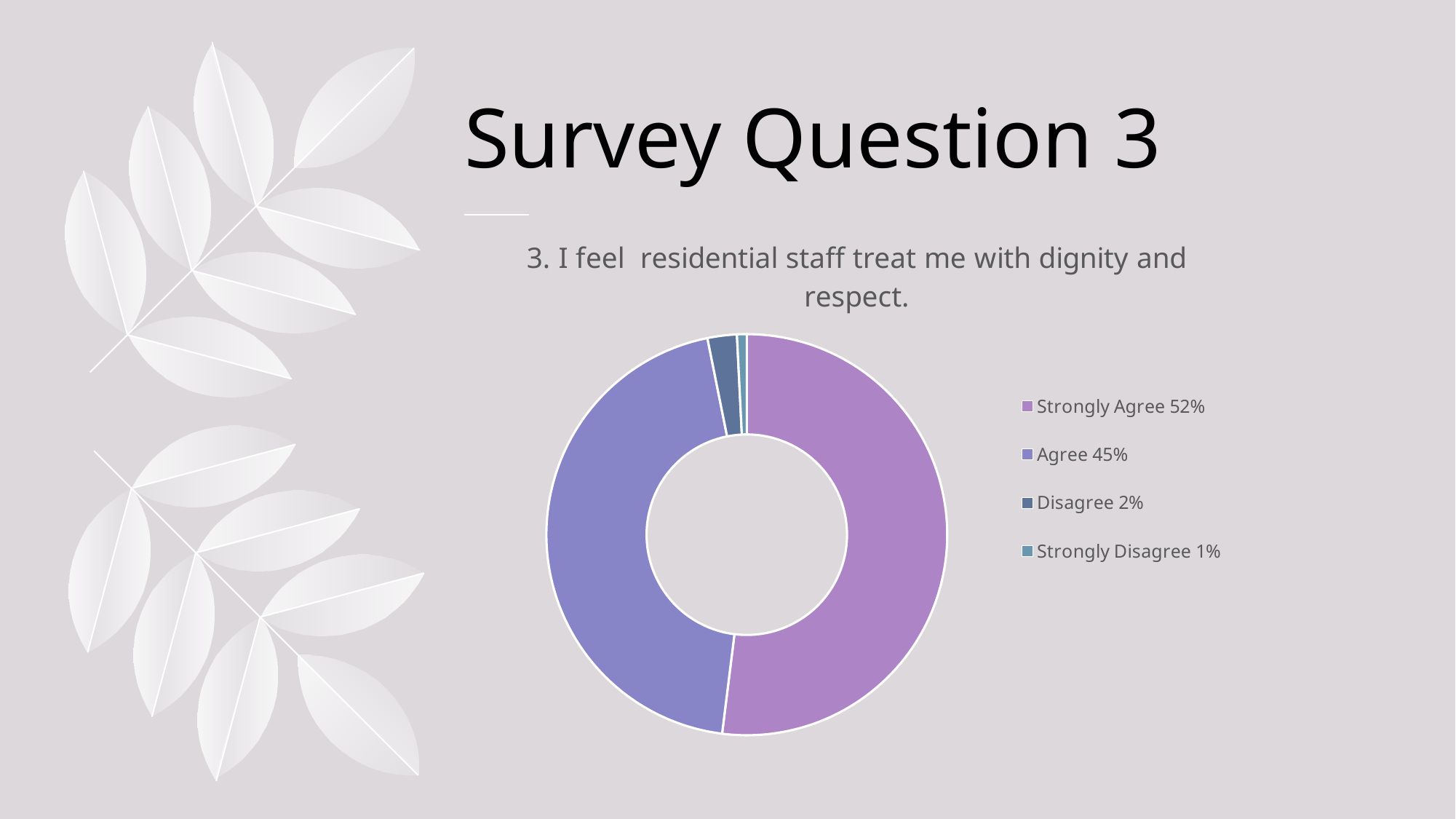
Which response category has the smallest share? Strongly Disagree How many response categories does the chart show? 4 What percentage of respondents answered Strongly Agree? 52% Which is larger, the share for Disagree or the share for Strongly Disagree? Disagree Which response category has the largest share? Strongly Agree What percentage of respondents answered Strongly Disagree? 1% What percentage of respondents answered Disagree? 2% What is the combined share of Strongly Agree and Agree? 97% What is the title of the chart? 3. I feel residential staff treat me with dignity and respect. What kind of chart is shown on the slide? Doughnut chart What percentage of respondents answered Agree? 45% What is the difference in percentage points between Strongly Agree and Agree? 7